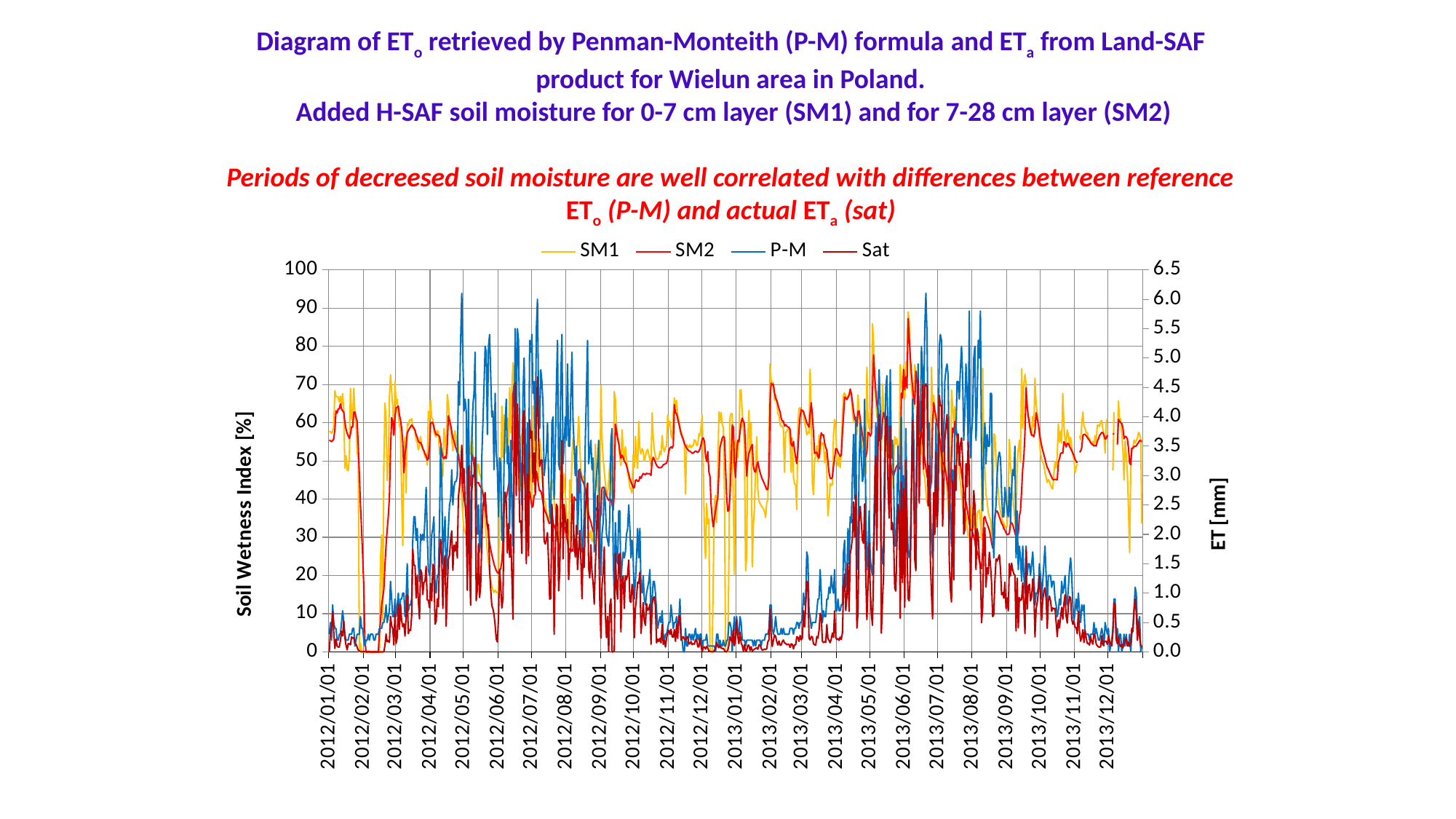
Is the highest value reached by the P-M series greater or less than 5.0 mm on the right axis? greater Around 2013/06/01, is the peak SM1 value greater or less than 80% on the left axis? greater During mid-2012, which series reaches higher values, P-M or Sat? P-M What kind of chart is shown on the slide? line chart Between 2013/09/01 and 2013/12/01, does the P-M series generally rise or fall? fall How many series does the legend list? 4 How many date labels are shown along the x axis? 24 What is the label of the right-hand vertical axis? ET [mm] Which series is plotted in blue? P-M Around 2012/11/01, is the Sat value greater or less than 1.0 mm on the right axis? less